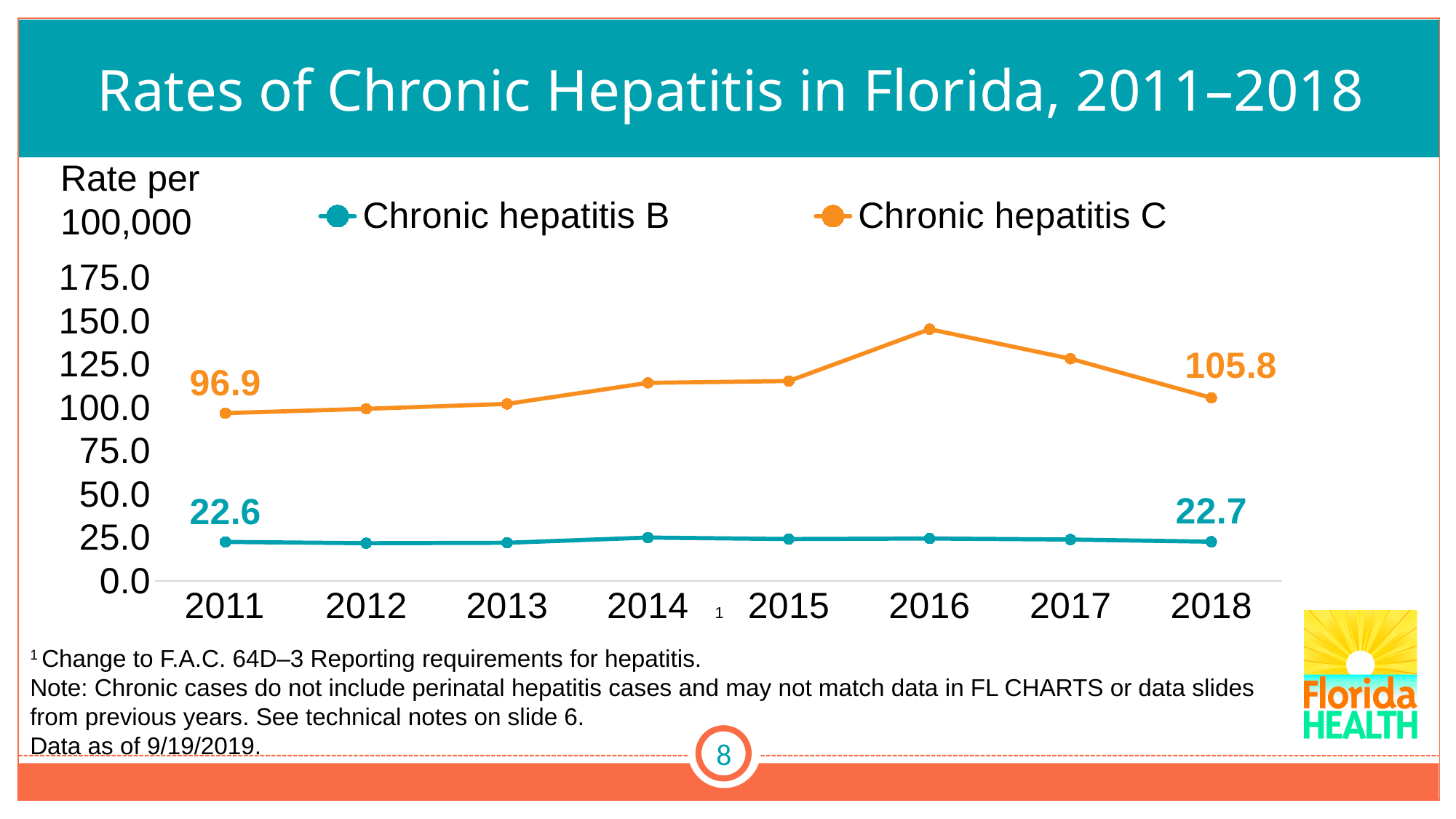
What is the rate of chronic hepatitis B in 2011? 22.6 What kind of chart is shown on the slide? Line chart What is the rate of chronic hepatitis C in 2011? 96.9 What is the rate of chronic hepatitis B in 2018? 22.7 What is the rate of chronic hepatitis C in 2018? 105.8 Is the chronic hepatitis C rate in 2016 greater or less than 125.0? greater Is the chronic hepatitis B rate in 2014 greater or less than 50.0? less How many years are shown on the x axis? 8 In which year is the chronic hepatitis C rate highest? 2016 How many series does the legend list? 2 What is the difference between the chronic hepatitis C rates in 2018 and 2011? 8.9 Which series has the higher rate in 2016, chronic hepatitis B or chronic hepatitis C? Chronic hepatitis C